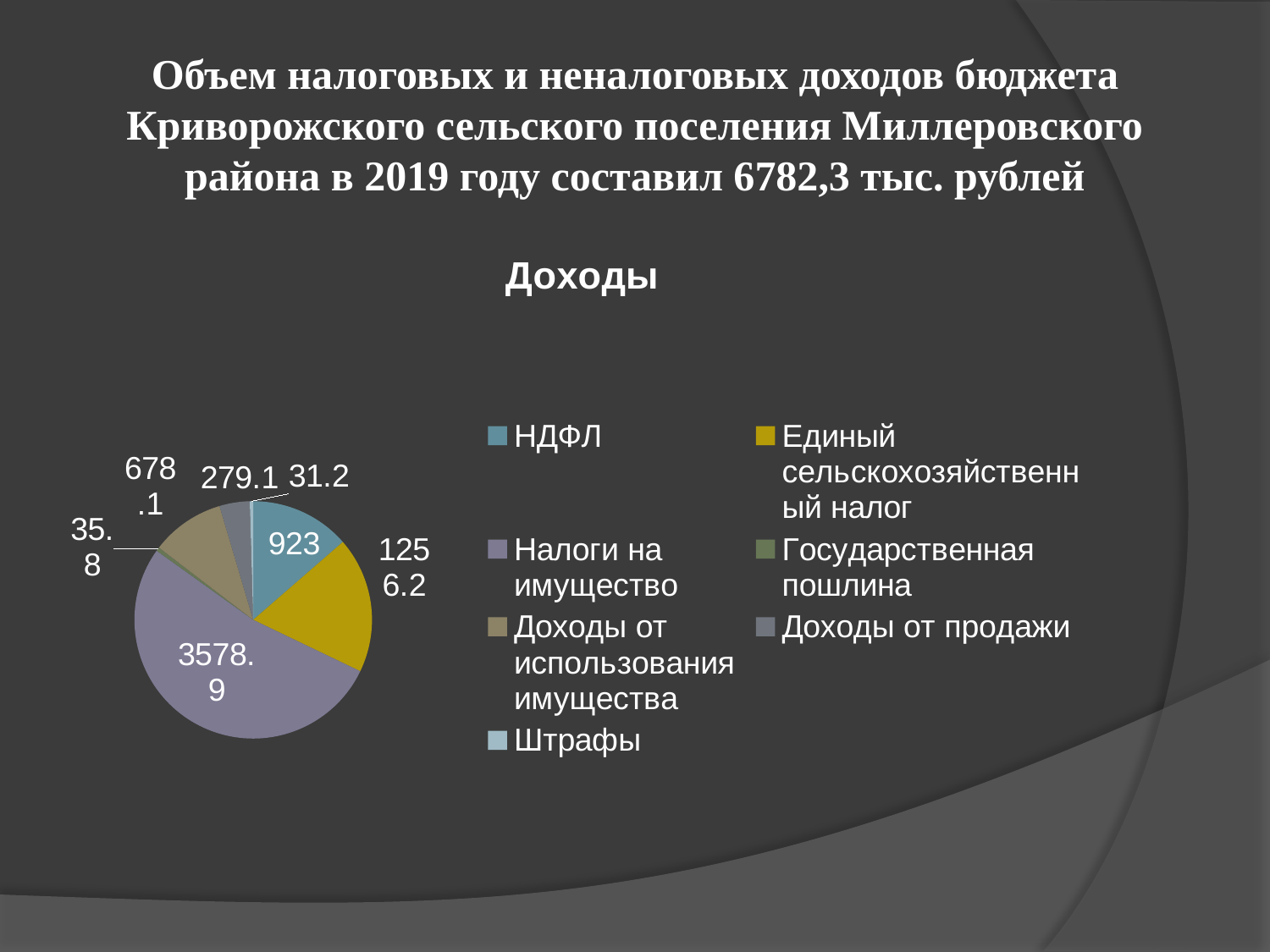
What is the difference between Налоги на имущество and Единый сельскохозяйственный налог? 2322.7 What is the value for Государственная пошлина? 35.8 Which category has the largest slice of the pie? Налоги на имущество What kind of chart is shown on the slide? pie chart What is the value for НДФЛ? 923 Which category has the smallest slice of the pie? Штрафы What is the value for Единый сельскохозяйственный налог? 1256.2 What is the value for Налоги на имущество? 3578.9 What share of the total 6782.3 does Налоги на имущество represent? 52.8% What is the title of the chart? Доходы Which is larger, Доходы от использования имущества or Доходы от продажи? Доходы от использования имущества How many categories does the pie chart have? 7